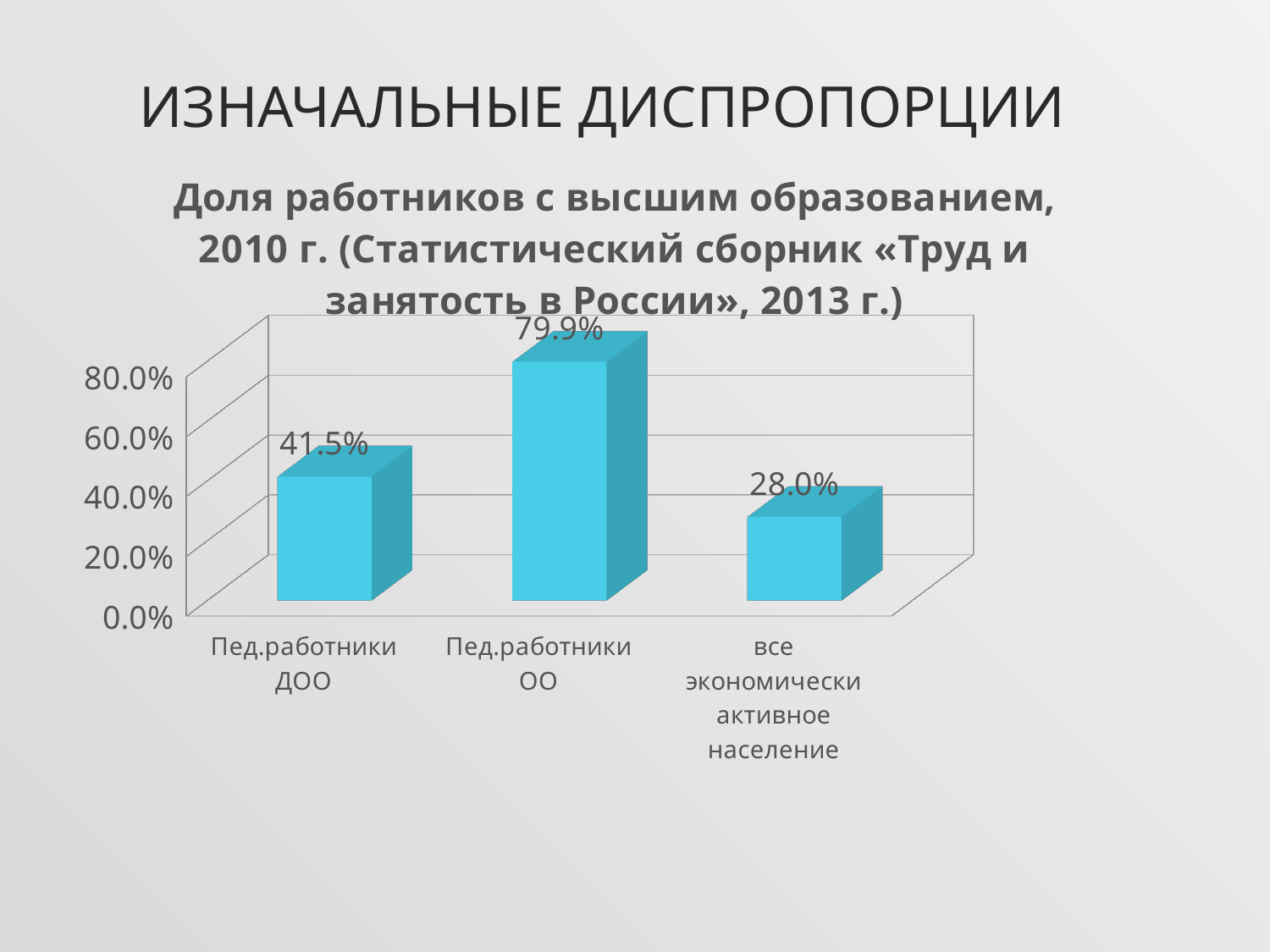
Which is larger: the value for Пед.работники ДОО or the value for все экономически активное население? Пед.работники ДОО What kind of chart is shown on the slide? bar chart Which category has the highest value? Пед.работники ОО What is the title of the chart? Доля работников с высшим образованием, 2010 г. (Статистический сборник «Труд и занятость в России», 2013 г.) Is the value for Пед.работники ОО greater or less than 60.0%? greater What is the value for все экономически активное население? 28.0% What is the difference between the values for Пед.работники ДОО and все экономически активное население? 13.5% What is the value for Пед.работники ОО? 79.9% What is the value for Пед.работники ДОО? 41.5% How many categories are shown in the chart? 3 What is the difference between the values for Пед.работники ОО and Пед.работники ДОО? 38.4% Which category has the lowest value? все экономически активное население